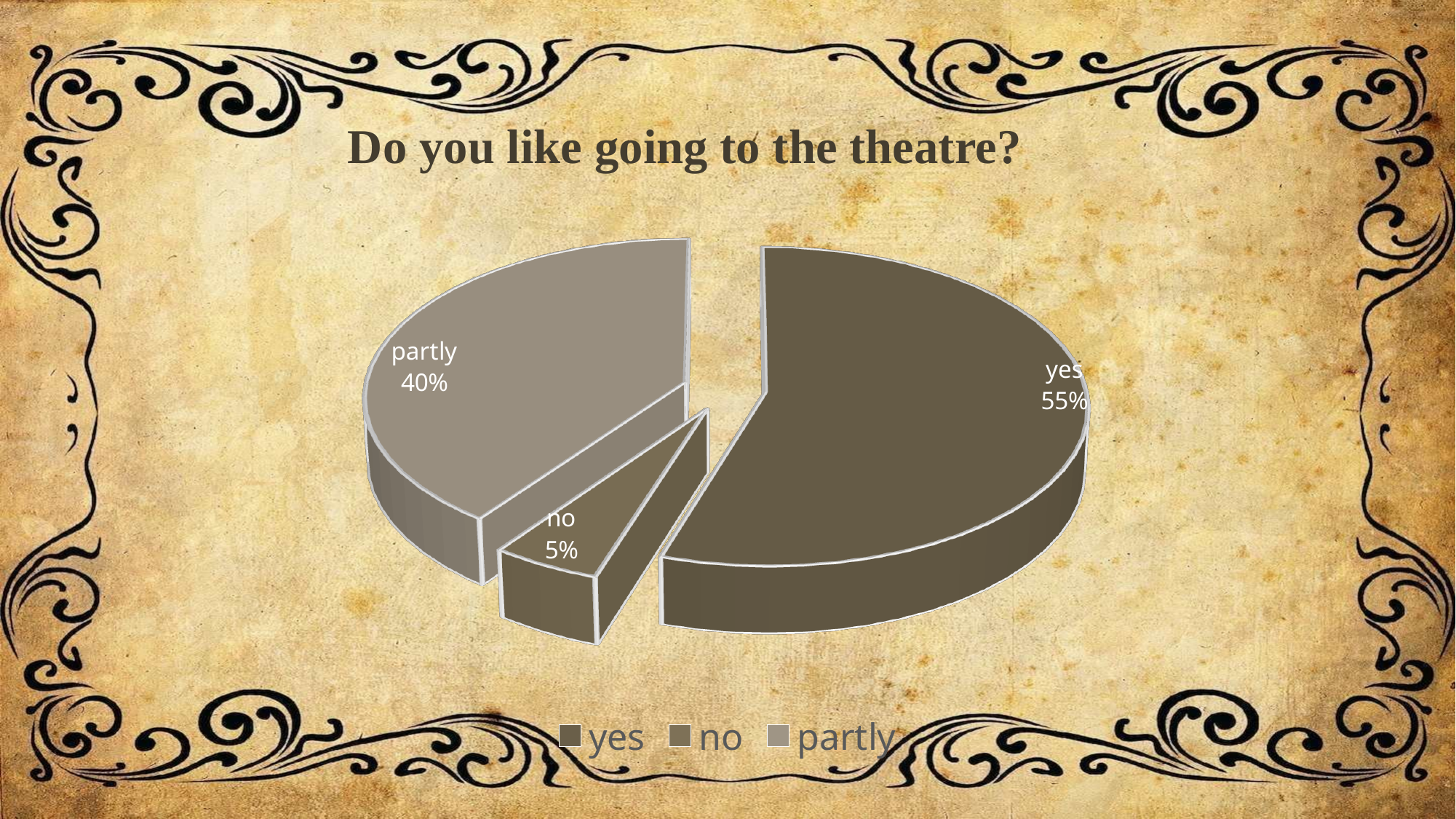
How many slices does the pie chart have? 3 Which is larger, the share for "partly" or the share for "no"? partly How many entries does the legend list? 3 What is the title of the chart? Do you like going to the theatre? What percentage of respondents answered "yes"? 55% What is the difference in percentage points between "yes" and "partly"? 15 Which answer has the largest share of the pie? yes What percentage of respondents answered "no"? 5% What type of chart is shown on the slide? pie chart Which answer has the smallest share of the pie? no What is the difference in percentage points between "partly" and "no"? 35 What percentage of respondents answered "partly"? 40%